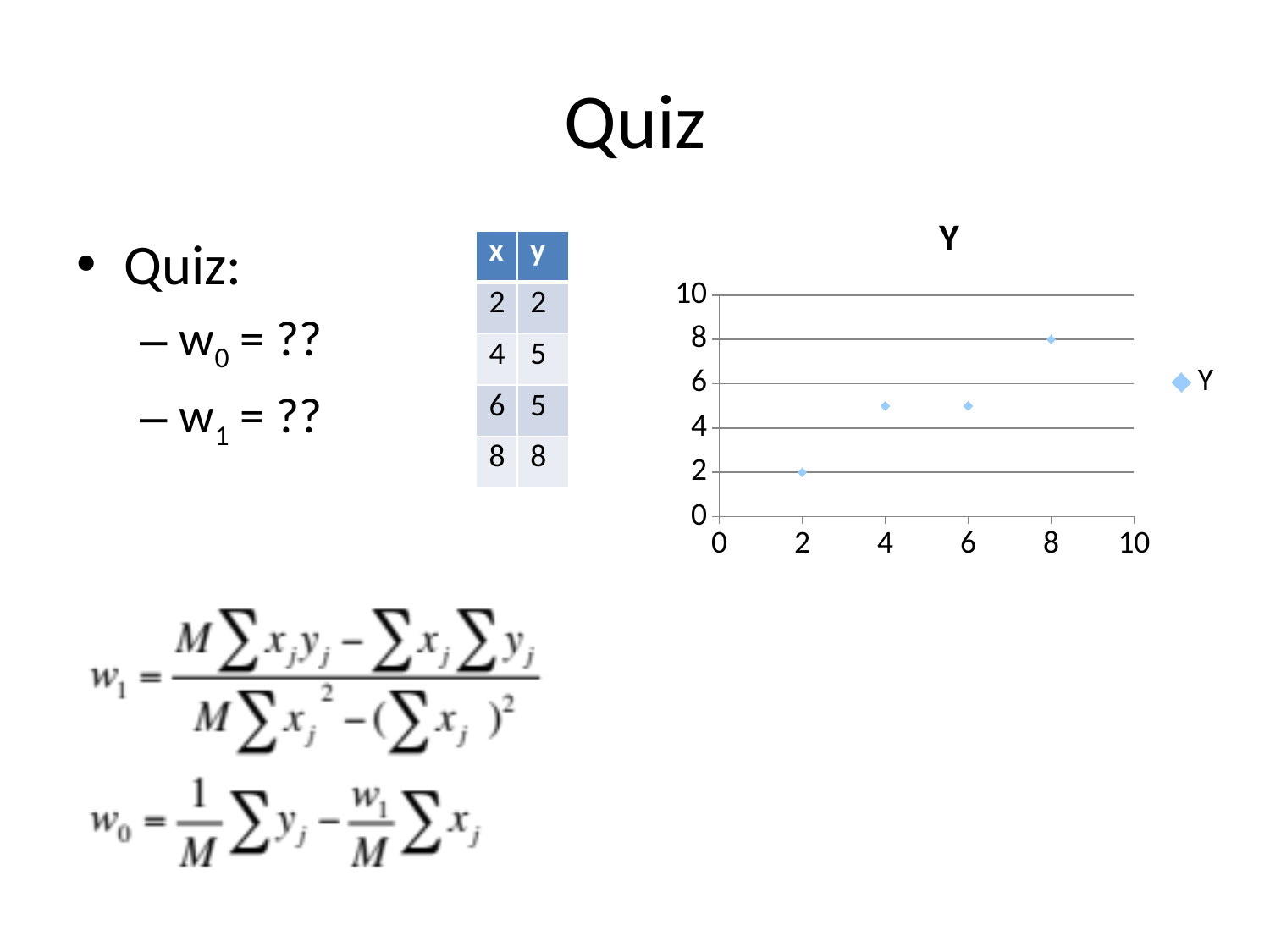
How many data points are plotted in the chart? 4 What is the y value of the point at x = 2? 2 What is the y value of the point at x = 8? 8 Which point has a larger y value, the one at x = 8 or the one at x = 2? x = 8 What is the difference between the y value at x = 8 and the y value at x = 2? 6 How many series does the chart's legend list? 1 What is the title of the chart? Y At which x value does the chart have its highest y value? 8 Is the y value of the point at x = 6 greater or less than 6? less Is the y value of the point at x = 4 greater or less than 4? greater At which x value does the chart have its lowest y value? 2 What kind of chart is shown on the slide? scatter chart